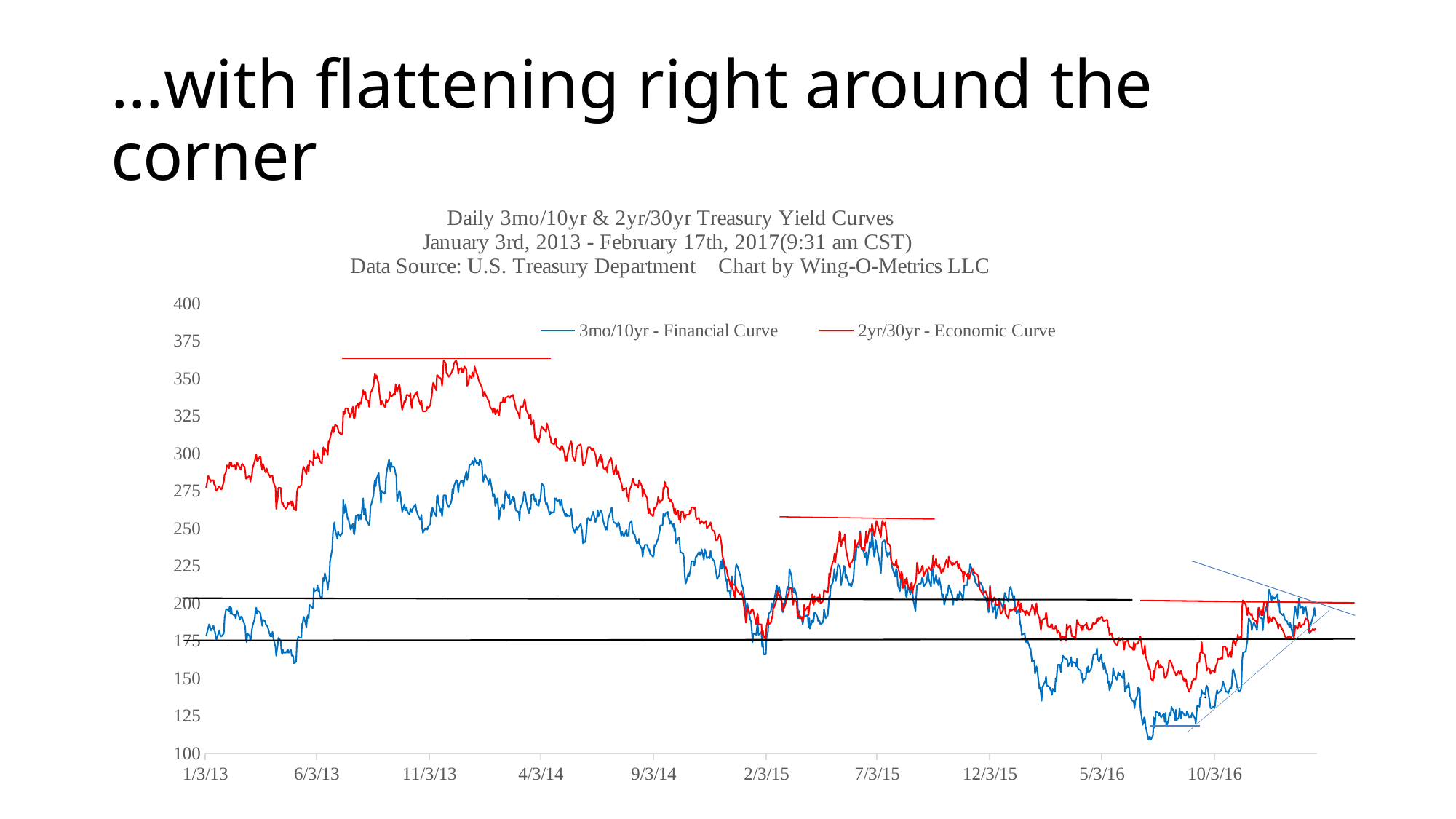
From 11/3/13 to 2/3/15, does the 2yr/30yr - Economic Curve generally rise or fall? fall At 11/3/13, which series has the higher value? 2yr/30yr - Economic Curve How many series does the chart's legend list? 2 Which series reaches the highest value anywhere on the chart? 2yr/30yr - Economic Curve What colour is the line for the 3mo/10yr - Financial Curve? blue Is the value of the 3mo/10yr - Financial Curve at 1/3/13 greater or less than 200? less What kind of chart is shown on the slide? line chart What are the two series named in the legend? 3mo/10yr - Financial Curve and 2yr/30yr - Economic Curve Is the peak value of the 2yr/30yr - Economic Curve greater or less than 350? greater Is the lowest value of the 3mo/10yr - Financial Curve greater or less than 125? less Which series reaches the lowest value anywhere on the chart? 3mo/10yr - Financial Curve